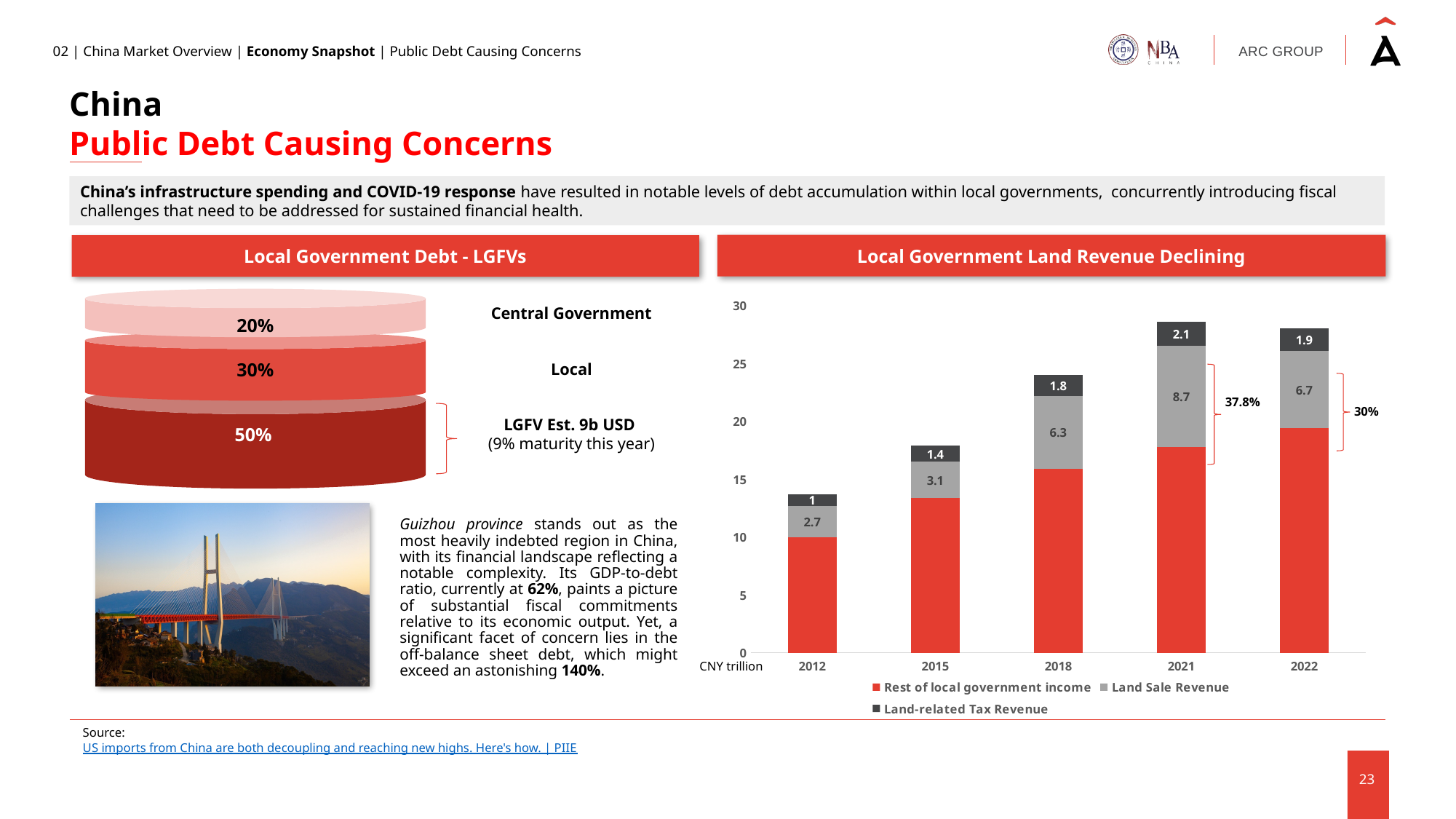
What kind of chart is 'Local Government Land Revenue Declining'? Stacked bar chart In the 'Local Government Land Revenue Declining' chart, is the total height of the 2021 bar greater or less than 25? greater In the 'Local Government Land Revenue Declining' chart, by how much did Land Sale Revenue fall from 2021 to 2022? 2 In the 'Local Government Land Revenue Declining' chart, which year has the lowest Land-related Tax Revenue? 2012 How many years are shown on the x axis of the 'Local Government Land Revenue Declining' chart? 5 In the 'Local Government Land Revenue Declining' chart, what is the Land-related Tax Revenue value for 2012? 1 How many series does the legend of the 'Local Government Land Revenue Declining' chart list? 3 In the 'Local Government Land Revenue Declining' chart, is Land-related Tax Revenue larger in 2015 or in 2018? 2018 In the 'Local Government Land Revenue Declining' chart, what is the Land Sale Revenue value for 2021? 8.7 What unit is shown at the bottom left of the 'Local Government Land Revenue Declining' chart's axis? CNY trillion In the 'Local Government Land Revenue Declining' chart, does Land Sale Revenue rise or fall from 2012 to 2021? Rise In the 'Local Government Land Revenue Declining' chart, which year has the highest Land Sale Revenue? 2021